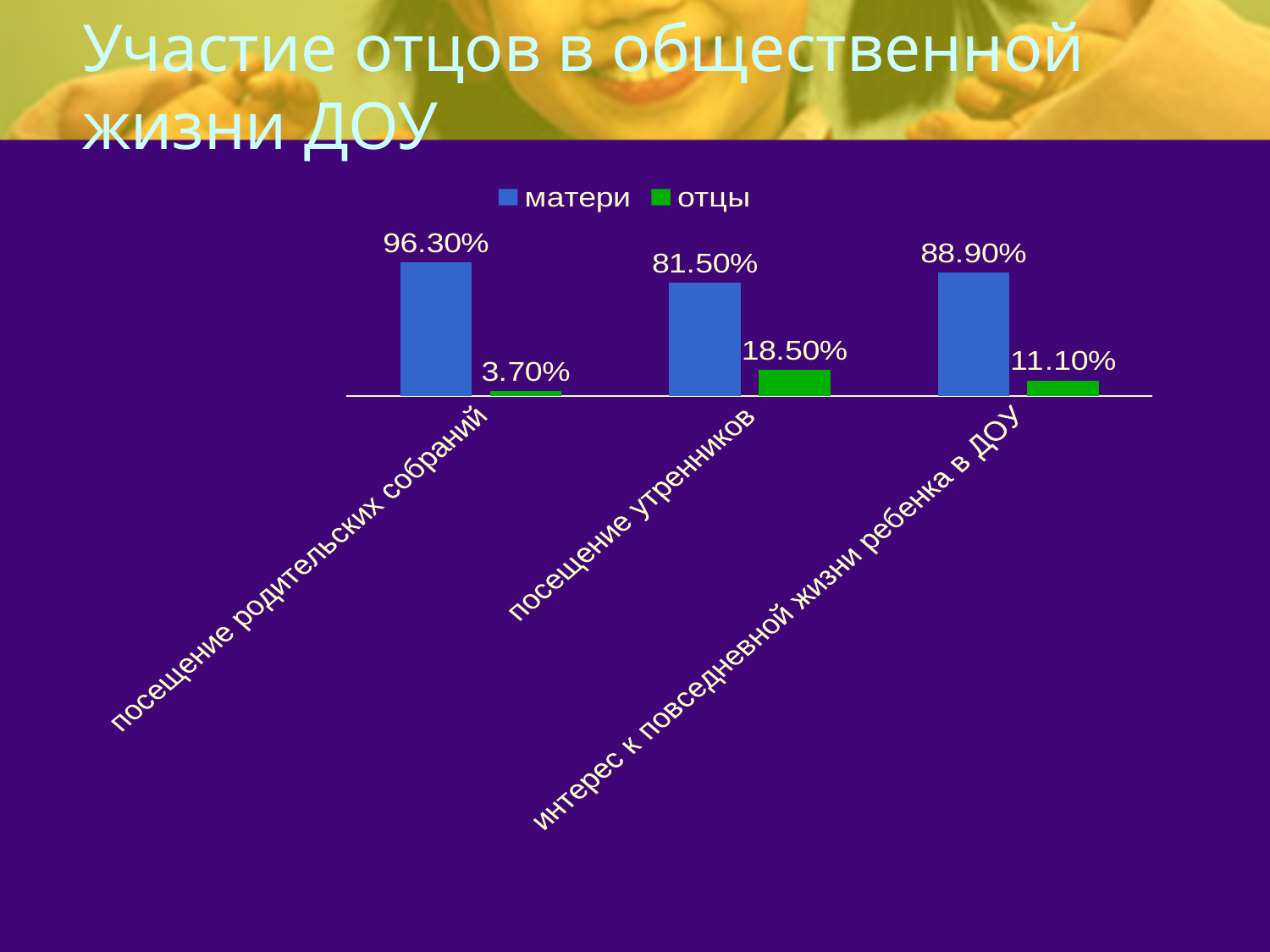
In which category is the value for отцы lowest? посещение родительских собраний In which category is the value for матери lowest? посещение утренников What kind of chart is shown on the slide? bar chart In which category is the value for отцы highest? посещение утренников What is the value for отцы in the category посещение утренников? 18.50% What is the value for матери in the category посещение родительских собраний? 96.30% Which is larger in the category интерес к повседневной жизни ребенка в ДОУ: матери or отцы? матери How many series does the legend list? 2 What is the value for матери in the category посещение утренников? 81.50% What is the difference between матери and отцы in the category посещение родительских собраний? 92.60% How many categories are shown on the x axis? 3 What is the value for отцы in the category интерес к повседневной жизни ребенка в ДОУ? 11.10%